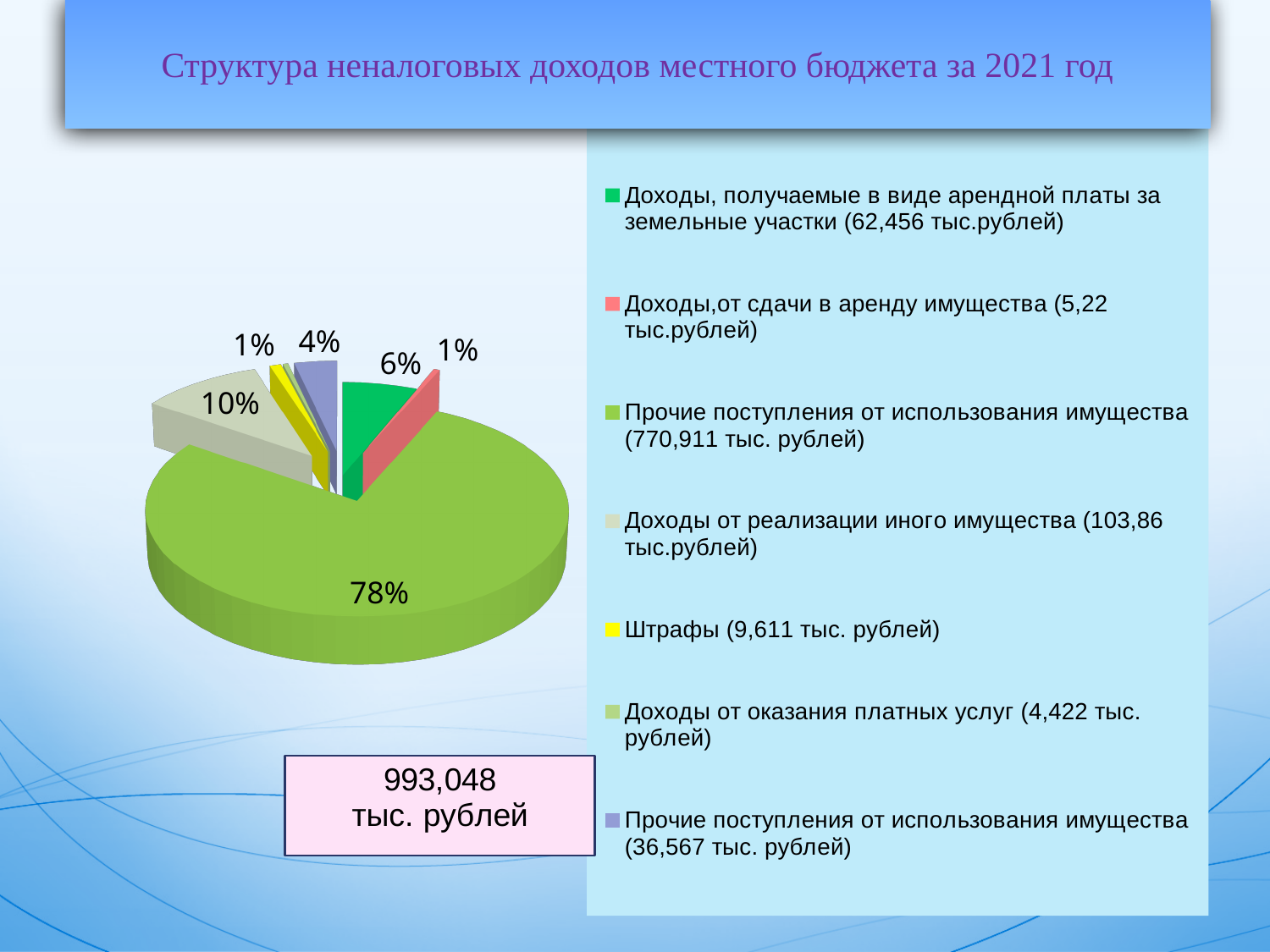
What percentage share is shown for Доходы от реализации иного имущества? 10% How many entries does the legend of the pie chart list? 7 What is the difference in percentage points between the 78% slice and the 10% slice? 68% What percentage share is shown for Доходы, получаемые в виде арендной платы за земельные участки? 6% Which category has the largest slice of the pie chart? Прочие поступления от использования имущества (770,911 тыс. рублей) What kind of chart is shown on the slide? Pie chart Which slice is larger: Доходы от реализации иного имущества or Доходы, получаемые в виде арендной платы за земельные участки? Доходы от реализации иного имущества What amount is given in the legend for Штрафы? 9,611 тыс. рублей What is the title of the slide with the pie chart? Структура неналоговых доходов местного бюджета за 2021 год What percentage share is shown for the largest slice of the pie chart? 78% What amount is given in the legend for Доходы от оказания платных услуг? 4,422 тыс. рублей